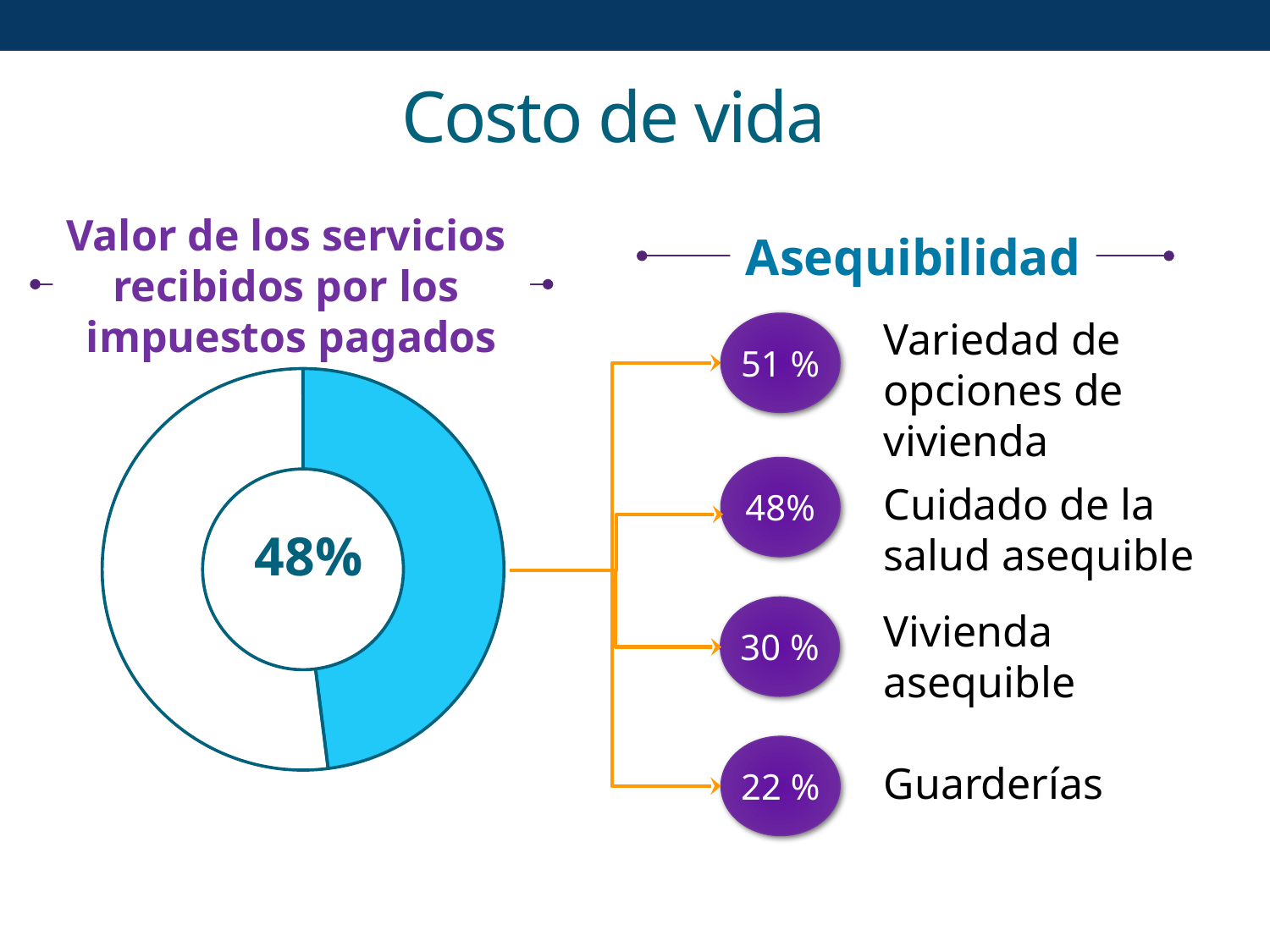
How many items are listed in the Asequibilidad section? 4 Is the value shown in the donut chart greater or less than 40%? greater What kind of chart is shown under the title "Valor de los servicios recibidos por los impuestos pagados"? Donut chart Is the value shown in the donut chart greater or less than 50%? less In the Asequibilidad section, which item has the lowest value? Guarderías What share of the donut chart is filled by the blue segment? 48% What colour is the filled segment of the donut chart? Blue What is the title of the donut chart? Valor de los servicios recibidos por los impuestos pagados In the Asequibilidad section, what value is shown for "Guarderías"? 22 % In the Asequibilidad section, what value is shown for "Variedad de opciones de vivienda"? 51 % What value is printed in the centre of the donut chart? 48% In the Asequibilidad section, which item has the highest value? Variedad de opciones de vivienda